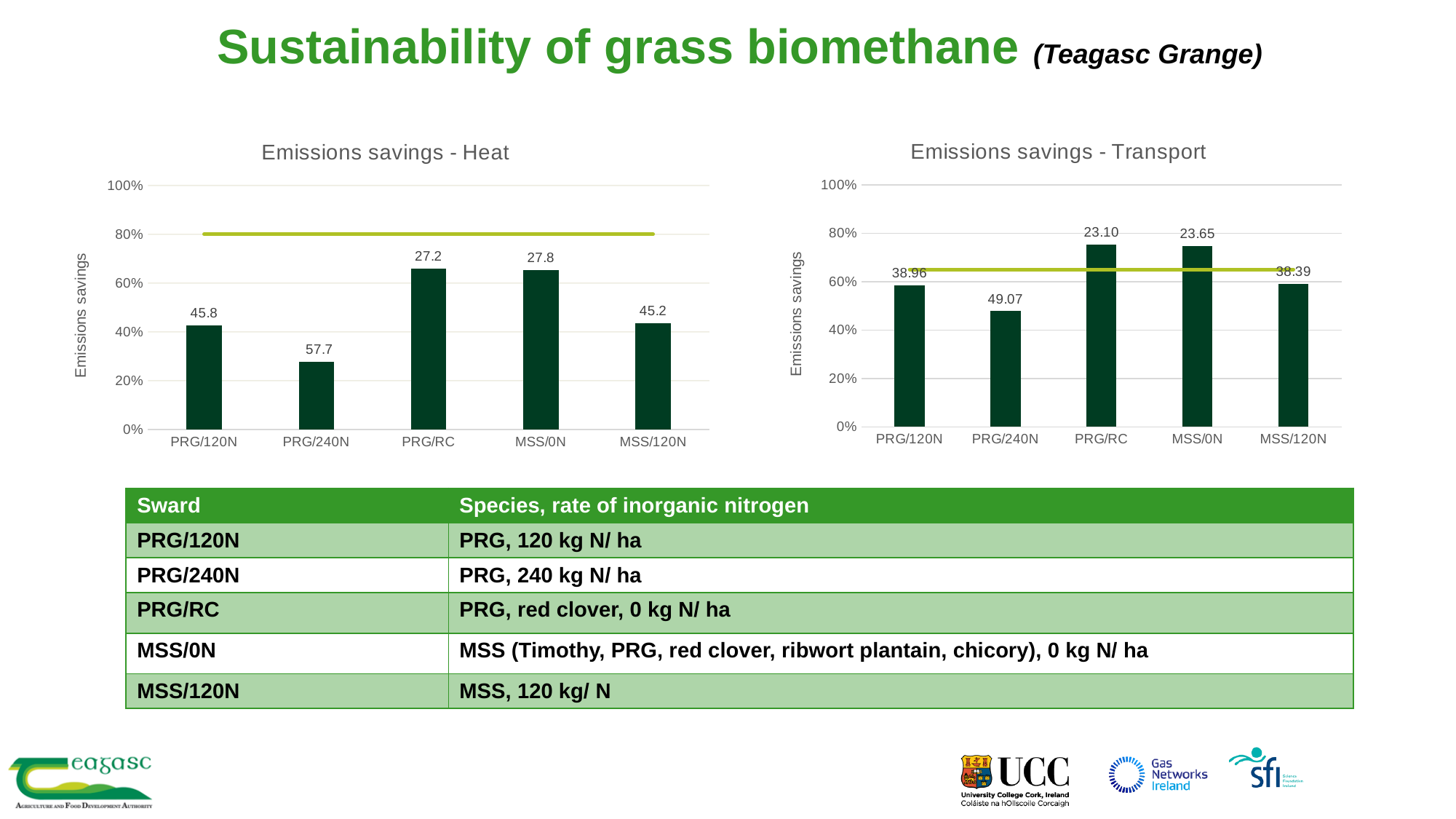
What type of chart is the 'Emissions savings - Heat' chart? bar chart What is the y-axis title of the 'Emissions savings - Heat' chart? Emissions savings In the 'Emissions savings - Heat' chart, what data label is printed above the PRG/240N bar? 57.7 In the 'Emissions savings - Transport' chart, is the bar for PRG/RC greater or less than 60%? greater How many categories are shown on the x axis of the 'Emissions savings - Transport' chart? 5 In the 'Emissions savings - Transport' chart, what data label is printed above the MSS/120N bar? 38.39 In the 'Emissions savings - Heat' chart, is the bar for PRG/RC taller or shorter than the bar for MSS/120N? taller In the 'Emissions savings - Heat' chart, what data label is printed above the PRG/120N bar? 45.8 In the 'Emissions savings - Heat' chart, which category has the lowest bar? PRG/240N In the 'Emissions savings - Heat' chart, is the bar for PRG/240N greater or less than 40%? less In the 'Emissions savings - Transport' chart, what data label is printed above the PRG/RC bar? 23.10 In the 'Emissions savings - Transport' chart, which category has the lowest bar? PRG/240N